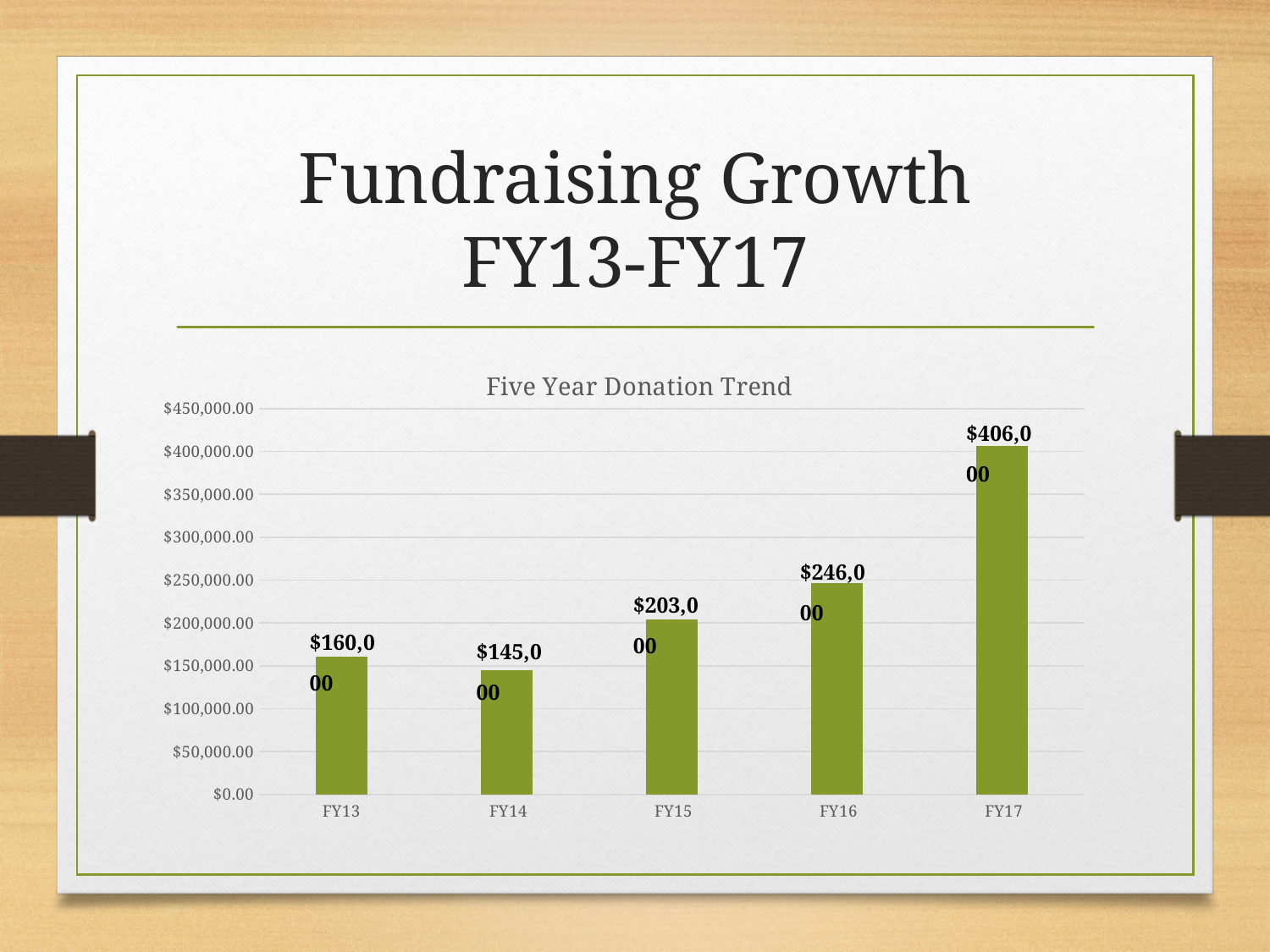
How many fiscal years are shown on the chart? 5 What kind of chart is shown on the slide? bar chart What is the donation value for FY13? $160,000 Which is larger, the donation value for FY15 or FY16? FY16 What is the difference between the donation values for FY17 and FY16? $160,000 What is the difference between the donation values for FY13 and FY14? $15,000 What is the donation value for FY15? $203,000 Which fiscal year has the lowest donation value? FY14 What is the title of the chart? Five Year Donation Trend Is the value for FY16 greater or less than $200,000.00? greater Which fiscal year has the highest donation value? FY17 What is the donation value for FY17? $406,000